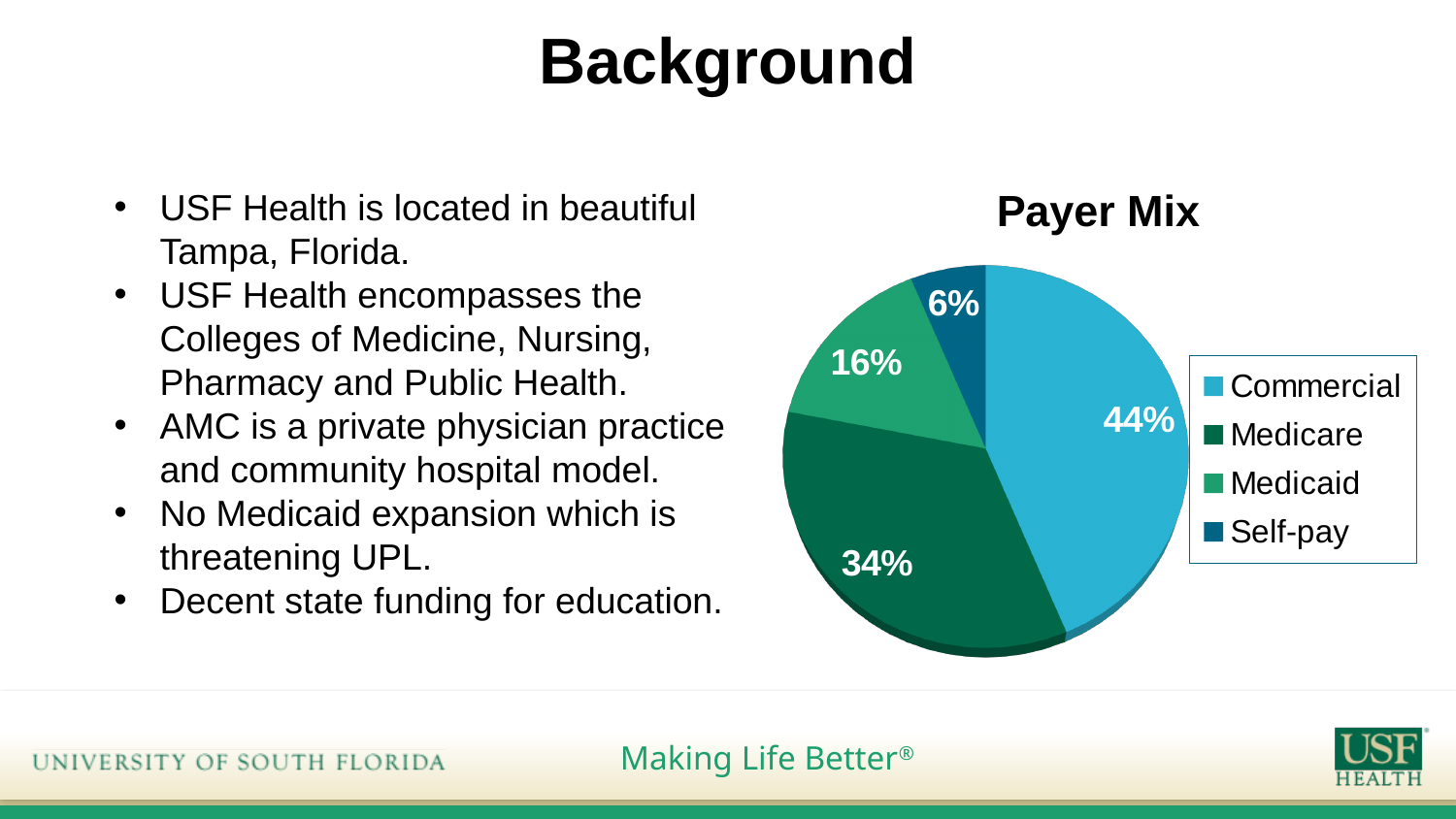
What type of chart is shown under the title "Payer Mix"? Pie chart What percentage of the Payer Mix is Medicaid? 16% Which payer category has the smallest share of the Payer Mix? Self-pay Which payer category has the largest share of the Payer Mix? Commercial How many categories are shown in the Payer Mix pie chart? 4 What percentage of the Payer Mix is Self-pay? 6% What percentage of the Payer Mix is Commercial? 44% What is the title of the chart on the slide? Payer Mix Which is larger in the Payer Mix, Medicaid or Self-pay? Medicaid What percentage of the Payer Mix is Medicare? 34% What is the difference in percentage points between the Commercial and Medicare shares of the Payer Mix? 10 What is the combined share of Medicare and Medicaid in the Payer Mix? 50%